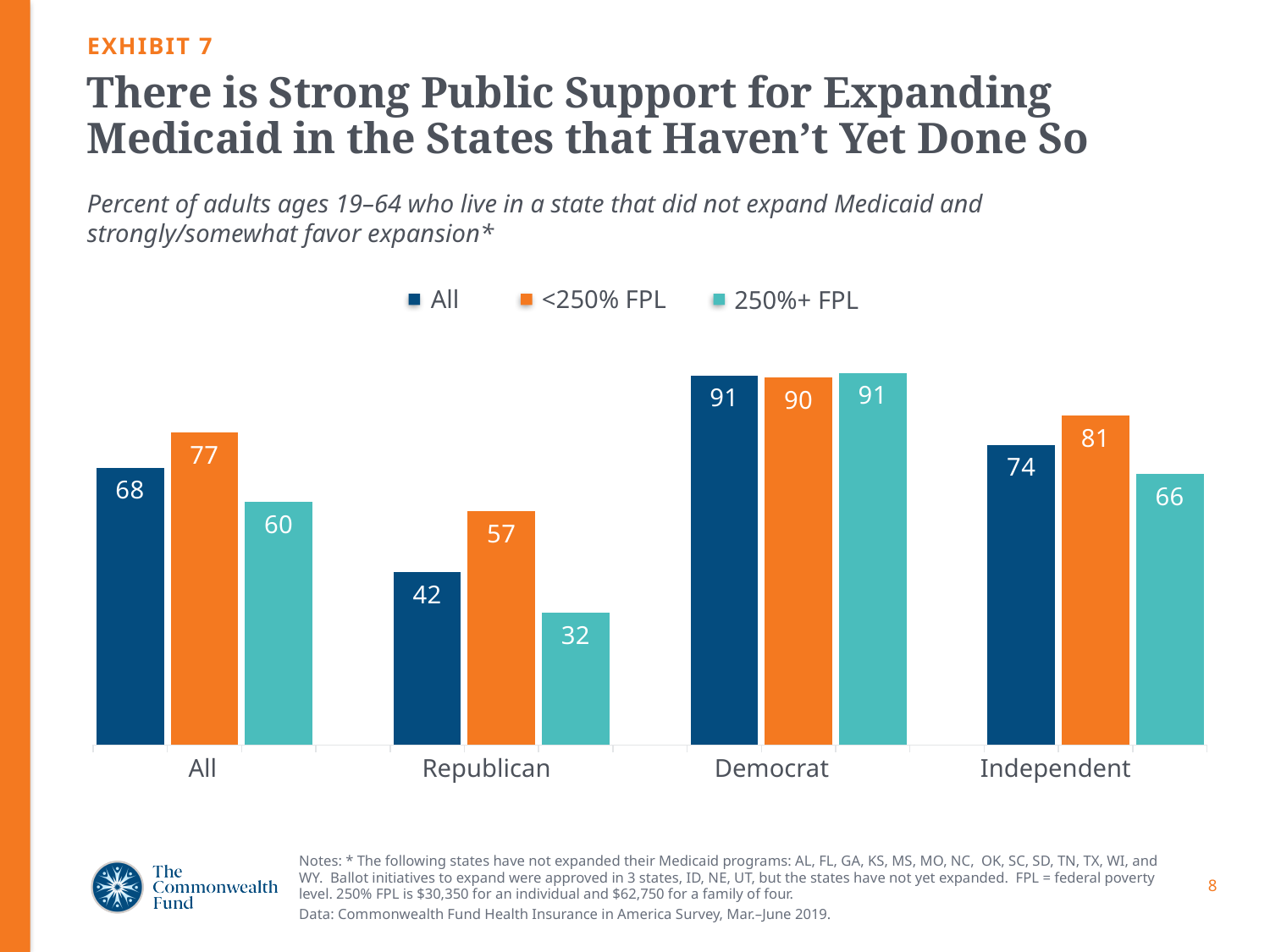
Which category has the highest value in the <250% FPL series? Democrat Which category has the lowest value in the 250%+ FPL series? Republican What is the difference between the <250% FPL and 250%+ FPL values for Republican? 25 Which series is shown in orange in the legend? <250% FPL Which is larger for Independent: the All value or the <250% FPL value? <250% FPL How many categories are shown on the x axis? 4 What is the value for Independent in the 250%+ FPL series? 66 What kind of chart is shown on the slide? Bar chart What is the value for Republican in the <250% FPL series? 57 What is the difference between the All values for Democrat and Republican? 49 How many series does the legend list? 3 What is the value for Democrat in the All series? 91